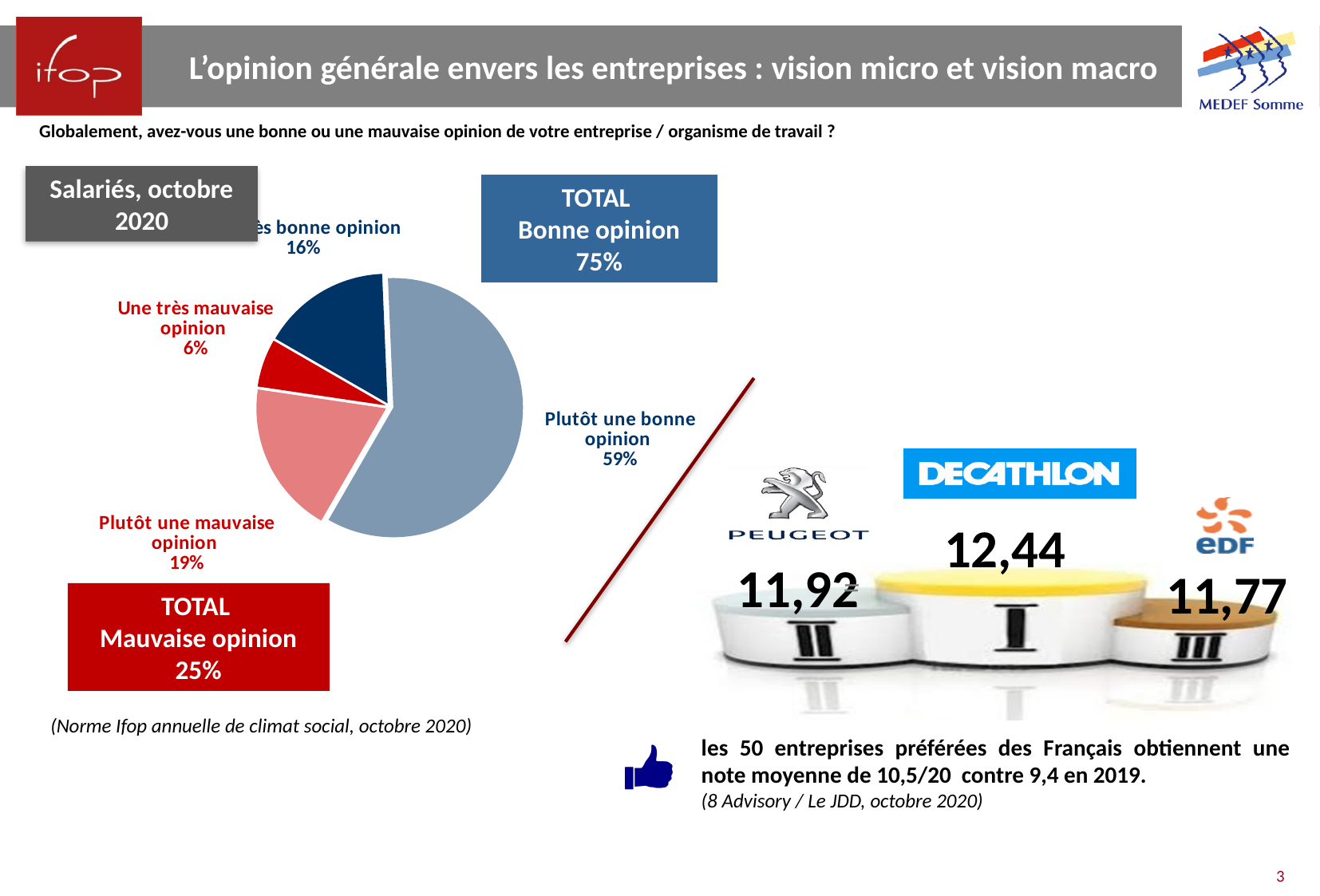
Which is larger in the pie chart: 'Une très bonne opinion' or 'Plutôt une mauvaise opinion'? Plutôt une mauvaise opinion What is the difference in percentage points between 'Plutôt une bonne opinion' and 'Plutôt une mauvaise opinion'? 40 What percentage of the pie chart is 'Plutôt une bonne opinion'? 59% What is the 'TOTAL Mauvaise opinion' value shown below the pie chart? 25% What kind of chart is shown on the left of the slide? Pie chart What percentage of the pie chart is 'Une très mauvaise opinion'? 6% What percentage of the pie chart is 'Plutôt une mauvaise opinion'? 19% Which slice of the pie chart is the smallest? Une très mauvaise opinion What is the 'TOTAL Bonne opinion' value shown next to the pie chart? 75% How many slices does the pie chart have? 4 Which slice of the pie chart is the largest? Plutôt une bonne opinion What percentage of the pie chart is 'Une très bonne opinion'? 16%